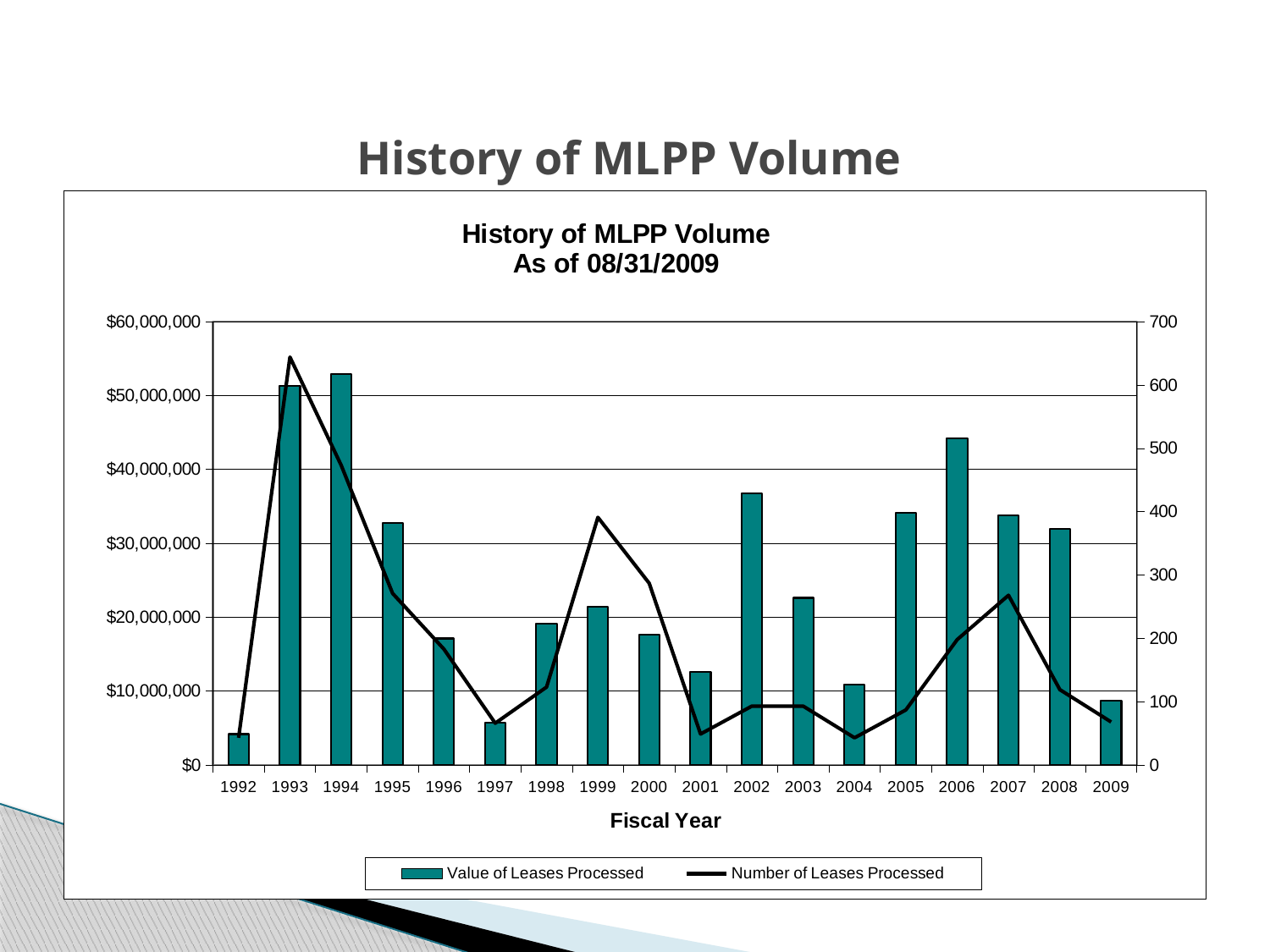
What kind of chart is shown on the slide? A combined bar and line chart In which fiscal year does the Number of Leases Processed line reach its highest point? 1993 Do the Value of Leases Processed bars rise or fall from 2006 to 2009? fall Is the Number of Leases Processed for 1999 greater or less than 300? greater Which fiscal year has the larger Value of Leases Processed, 2002 or 2003? 2002 What is the label of the x axis of the chart? Fiscal Year Is the Value of Leases Processed for 1997 greater or less than $10,000,000? less Is the Value of Leases Processed for 2006 greater or less than $40,000,000? greater How many fiscal years are shown on the x axis of the chart? 18 Which fiscal year has the lowest Value of Leases Processed bar? 1992 How many series does the chart's legend list? 2